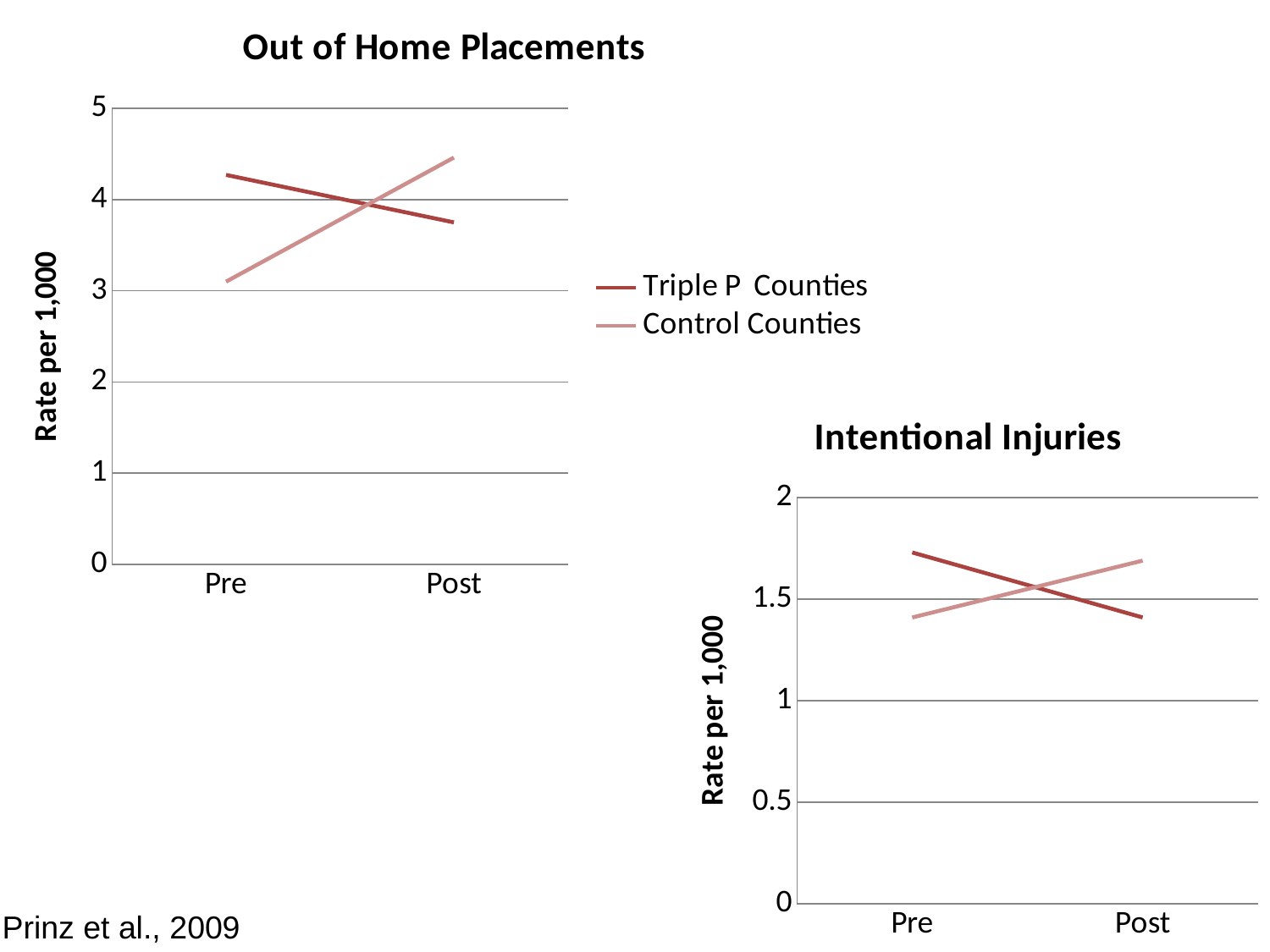
In the "Out of Home Placements" chart, which series has the higher value at Pre? Triple P Counties In the "Out of Home Placements" chart, how many points are on the x axis? 2 In the "Out of Home Placements" chart, is the Pre value for Triple P Counties greater or less than 4? greater In the "Out of Home Placements" chart, does the Triple P Counties line rise or fall from Pre to Post? fall How many series does the legend list? 2 In the "Out of Home Placements" chart, is the Post value for Control Counties greater or less than 4? greater What is the y-axis label of the "Intentional Injuries" chart? Rate per 1,000 In the "Intentional Injuries" chart, is the Post value for Triple P Counties greater or less than 1.5? less In the "Intentional Injuries" chart, which series has the higher value at Post? Control Counties In the "Intentional Injuries" chart, does the Triple P Counties line rise or fall from Pre to Post? fall What kind of chart is the "Out of Home Placements" chart? line chart In the "Out of Home Placements" chart, does the Control Counties line rise or fall from Pre to Post? rise